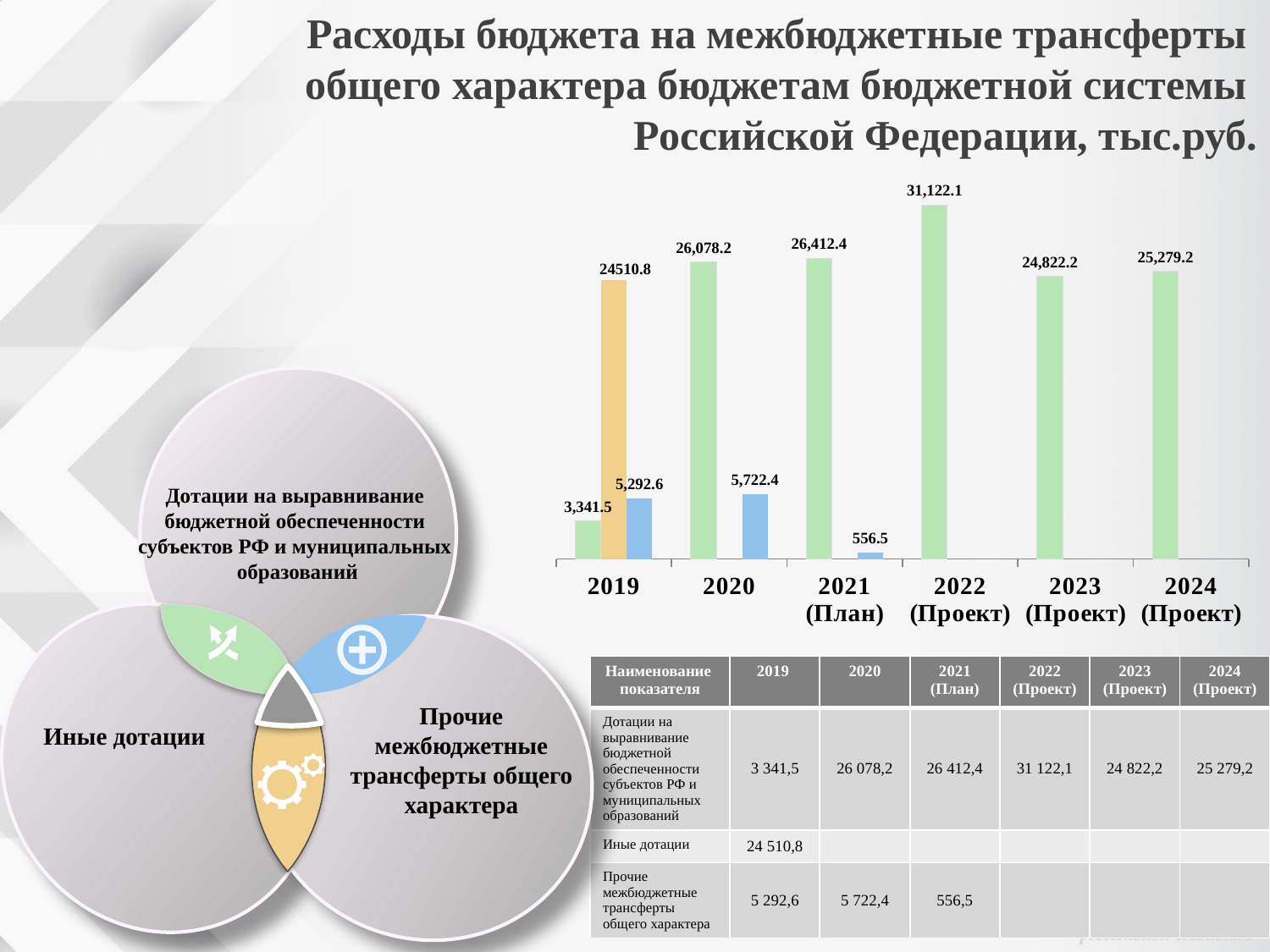
In which year does the green series reach its highest value? 2022 (Проект) What is the difference between the green bar values for 2022 (Проект) and 2023 (Проект)? 6,299.9 What is the value of the green bar for 2024 (Проект)? 25,279.2 What is the value of the blue bar for 2021 (План)? 556.5 What type of chart is shown on the slide? bar chart What is the value of the green bar for 2022 (Проект)? 31,122.1 Which year is the only one with an orange bar in the chart? 2019 Does the blue series rise or fall from 2020 to 2021 (План)? fall What is the value of the orange bar for 2019? 24510.8 How many year categories are shown on the x axis of the chart? 6 Which is larger in 2019: the green bar or the blue bar? the blue bar In which year does the green series have its lowest value? 2019